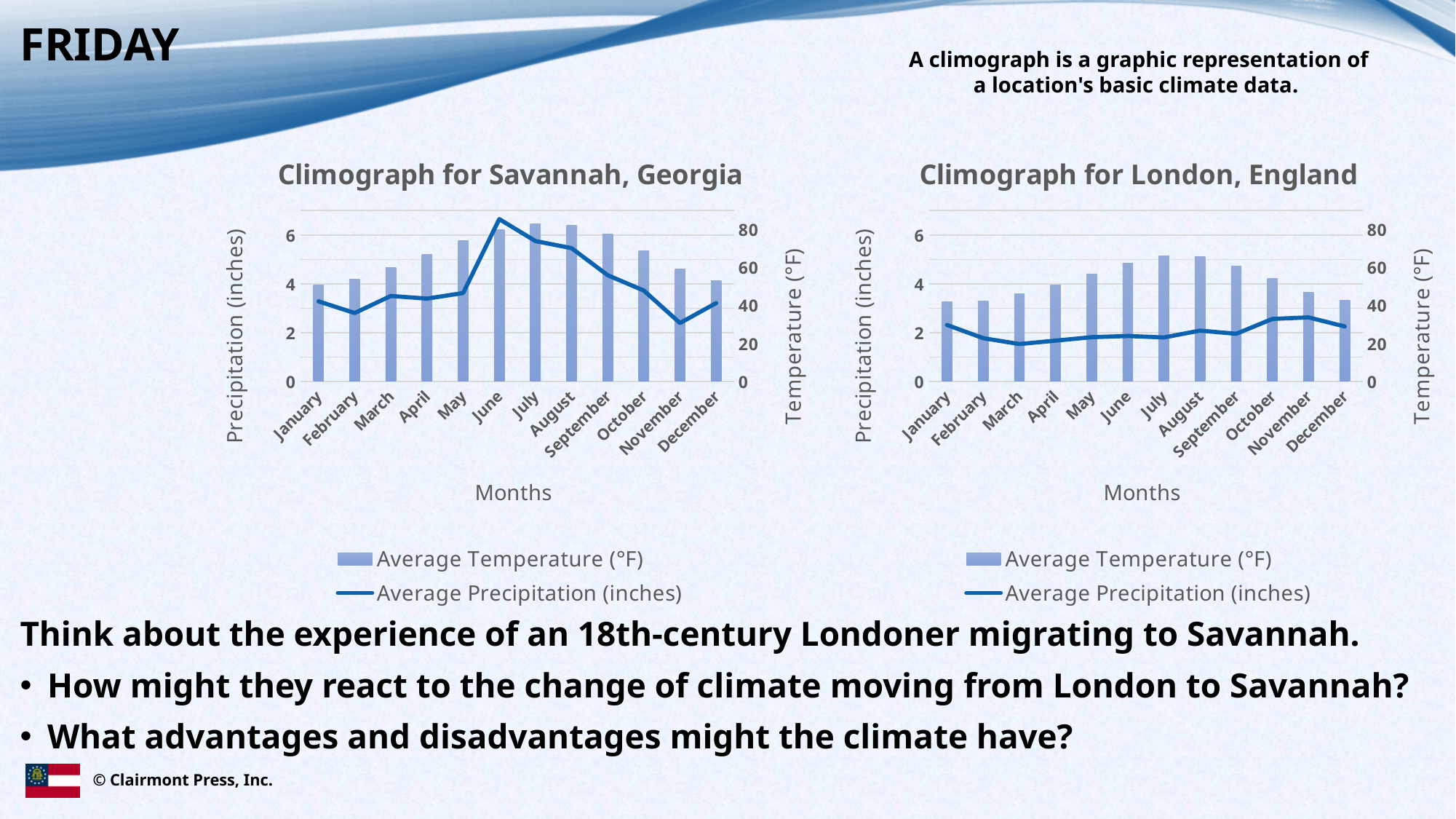
On the Climograph for London, England, how many series does the legend list? 2 On the Climograph for Savannah, Georgia, which series is drawn as a line? Average Precipitation (inches) On the Climograph for London, England, what is the label of the right-hand vertical axis? Temperature (°F) On the Climograph for Savannah, Georgia, which month has the lowest average precipitation? November On the Climograph for Savannah, Georgia, how many months are shown on the x axis? 12 Comparing the two charts, is the average temperature for July higher in Savannah, Georgia or in London, England? Savannah, Georgia What kind of chart is the Climograph for Savannah, Georgia? Combined bar and line chart On the Climograph for Savannah, Georgia, is the average temperature for July greater or less than 80? greater On the Climograph for Savannah, Georgia, is the average temperature for January greater or less than 60? less On the Climograph for London, England, is the average precipitation for March greater or less than 2? less On the Climograph for Savannah, Georgia, which month has the highest average precipitation? June